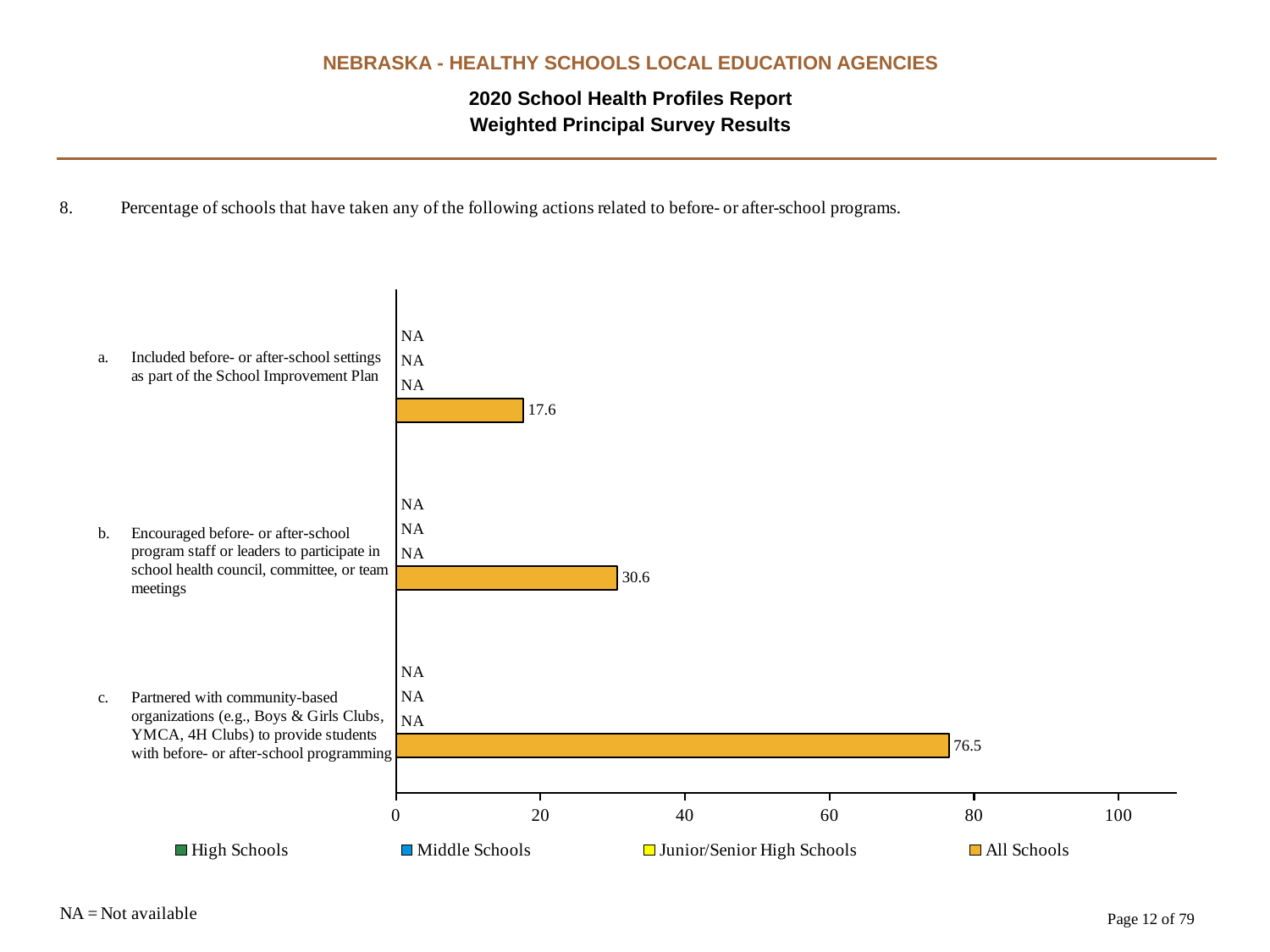
What is the All Schools value for item a, included before- or after-school settings as part of the School Improvement Plan? 17.6 What is the difference between the All Schools values for item c and item a? 58.9 What is the All Schools value for item b, encouraged before- or after-school program staff or leaders to participate in school health council, committee, or team meetings? 30.6 What is the difference between the All Schools values for item b and item a? 13 What value is shown for High Schools for item a? NA Which item has the highest All Schools value? c. Partnered with community-based organizations to provide before- or after-school programming How many series does the legend list? 4 What kind of chart is shown on the slide? bar chart Is the All Schools value for item b larger or smaller than the All Schools value for item c? smaller How many items (categories) are shown on the chart? 3 Which item has the lowest All Schools value? a. Included before- or after-school settings as part of the School Improvement Plan What is the All Schools value for item c, partnered with community-based organizations to provide before- or after-school programming? 76.5